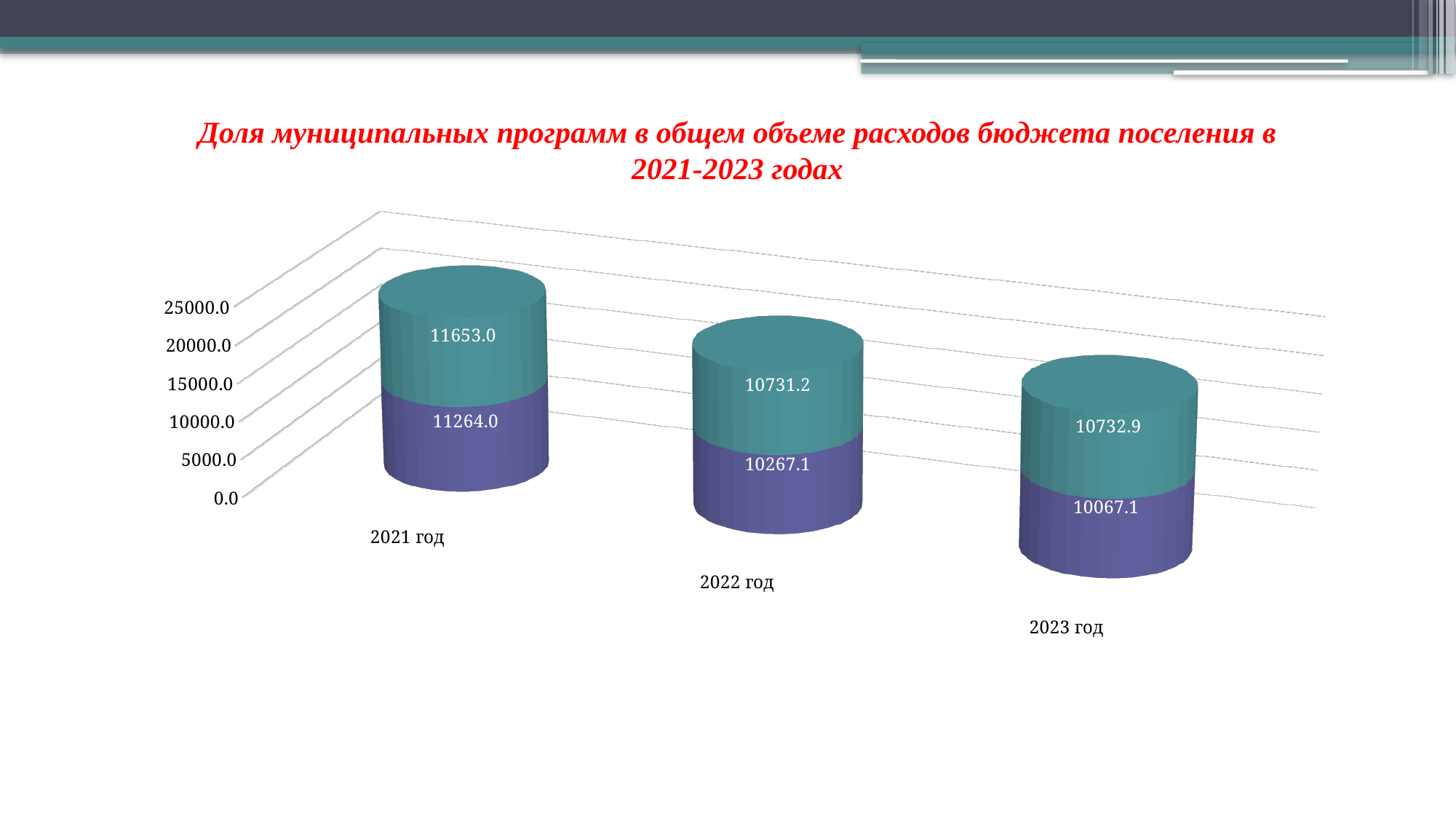
What is the value of the teal (upper) segment for 2022 год? 10731.2 Which year has the highest value for the purple (lower) segment? 2021 год What is the difference between the purple (lower) segment values for 2021 год and 2022 год? 996.9 Is the teal (upper) segment value for 2021 год larger than the teal segment value for 2022 год? Yes How many years (categories) are shown on the chart? 3 Which year has the lowest value for the purple (lower) segment? 2023 год What is the value of the purple (lower) segment for 2021 год? 11264.0 What kind of chart is shown on the slide? Stacked bar chart What is the value of the purple (lower) segment for 2023 год? 10067.1 What is the total of the stacked bar for 2023 год? 20800.0 What is the total of the stacked bar for 2021 год? 22917.0 What is the value of the teal (upper) segment for 2023 год? 10732.9